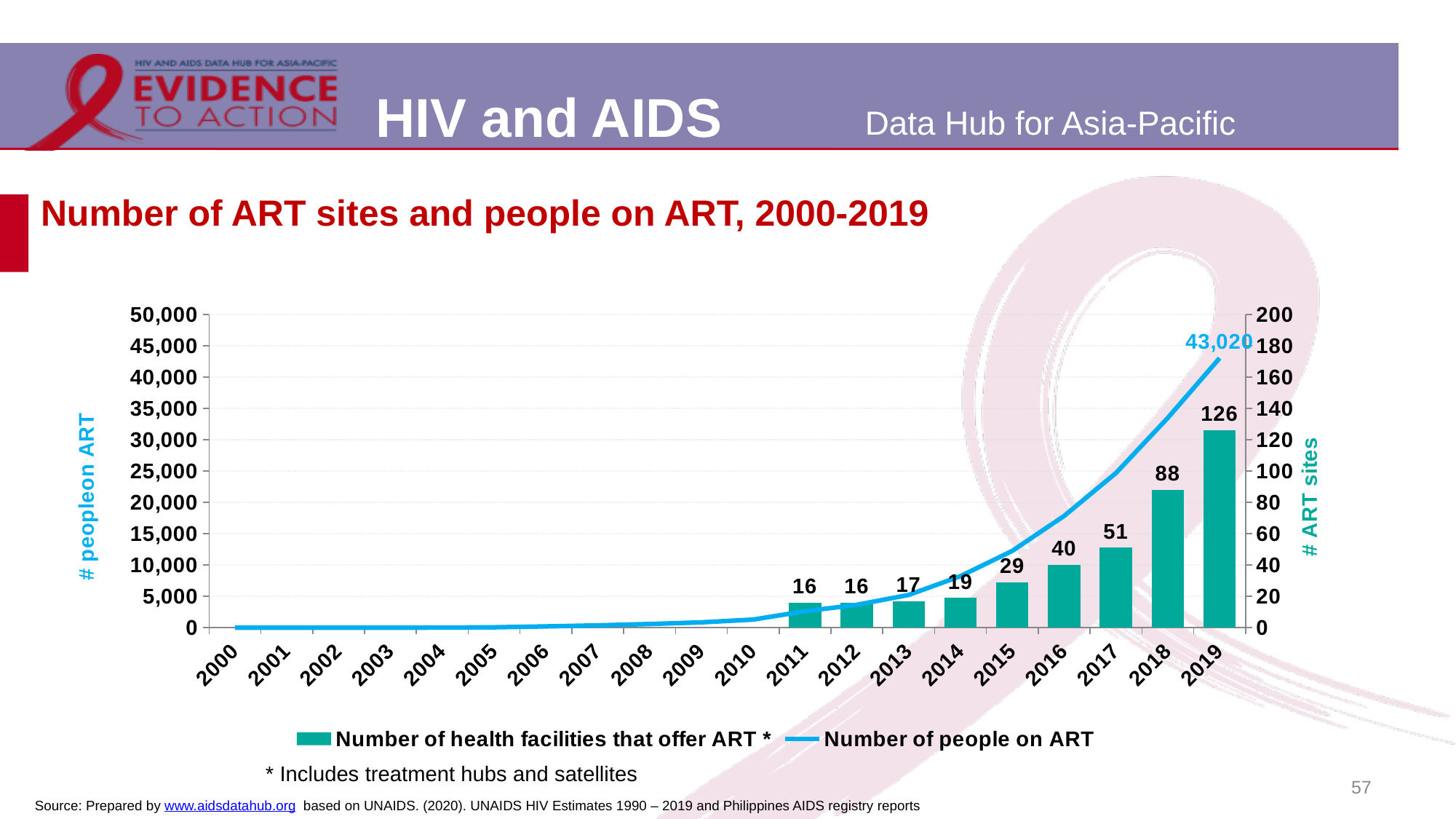
How many series does the legend list? 2 Which year has the highest number of health facilities that offer ART? 2019 Is the number of people on ART in 2017 greater or less than 15,000? greater Does the number of people on ART rise or fall from 2010 to 2019? rise How many health facilities offered ART in 2015? 29 Is the number of people on ART in 2018 greater or less than 20,000? greater What is the difference in the number of health facilities that offer ART between 2017 and 2016? 11 How many health facilities offered ART in 2019? 126 How many years are shown on the x axis? 20 What is the difference in the number of health facilities that offer ART between 2019 and 2018? 38 Which year had more health facilities that offer ART, 2014 or 2016? 2016 What was the number of people on ART in 2019? 43,020